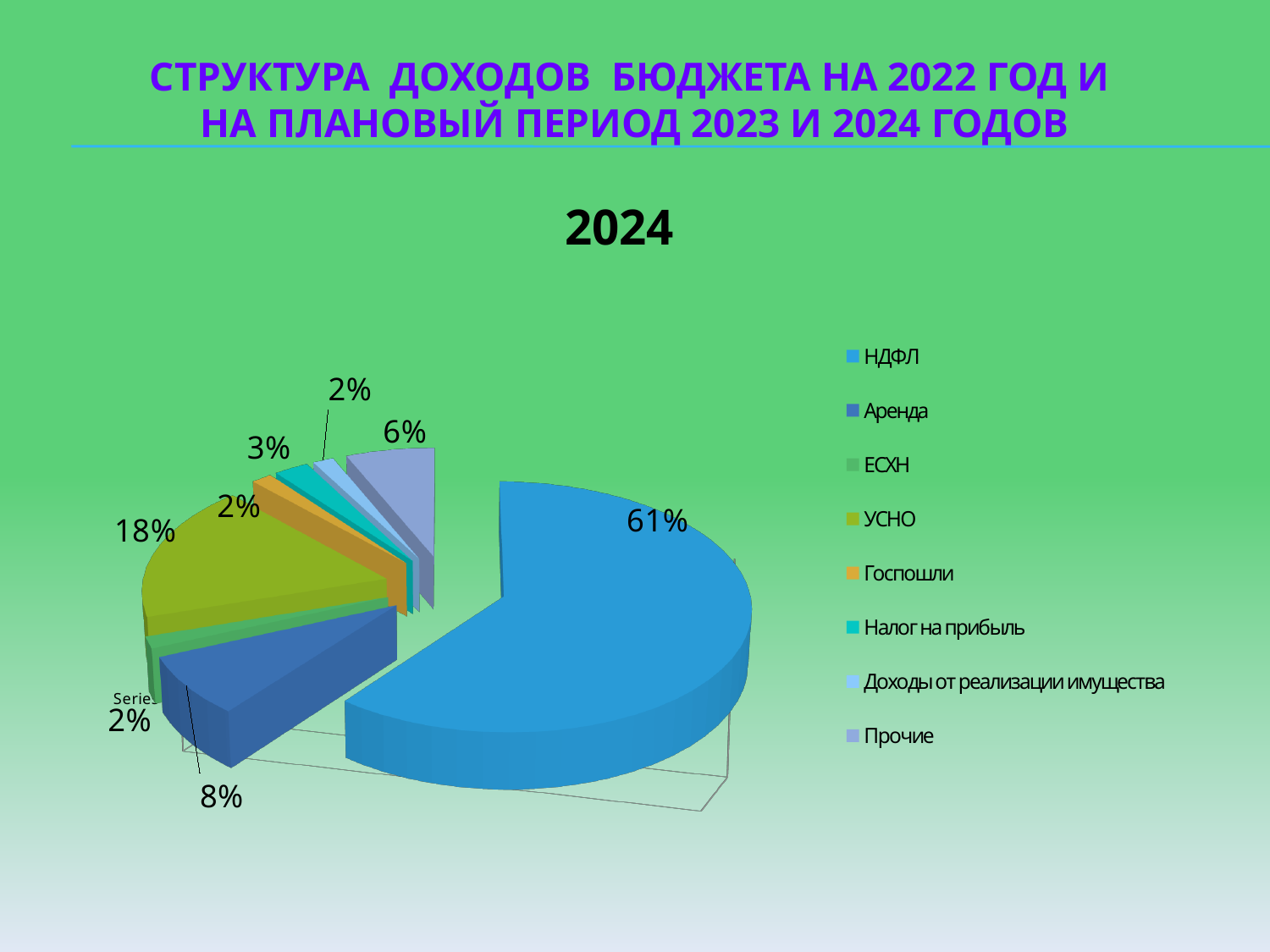
What percentage is labelled for Прочие? 6% What type of chart is shown on the slide? Pie chart How many categories does the legend list? 8 Which is larger, УСНО or Аренда? УСНО What is the value shown for Аренда? 8% What percentage of the 2024 pie chart is НДФЛ? 61% What is the difference between the Прочие and Налог на прибыль shares? 3 percentage points By how many percentage points does НДФЛ exceed УСНО? 43 percentage points What share of the pie does УСНО account for? 18% Which category has the largest slice of the pie? НДФЛ What year is given as the chart's title? 2024 What is the value for Налог на прибыль? 3%